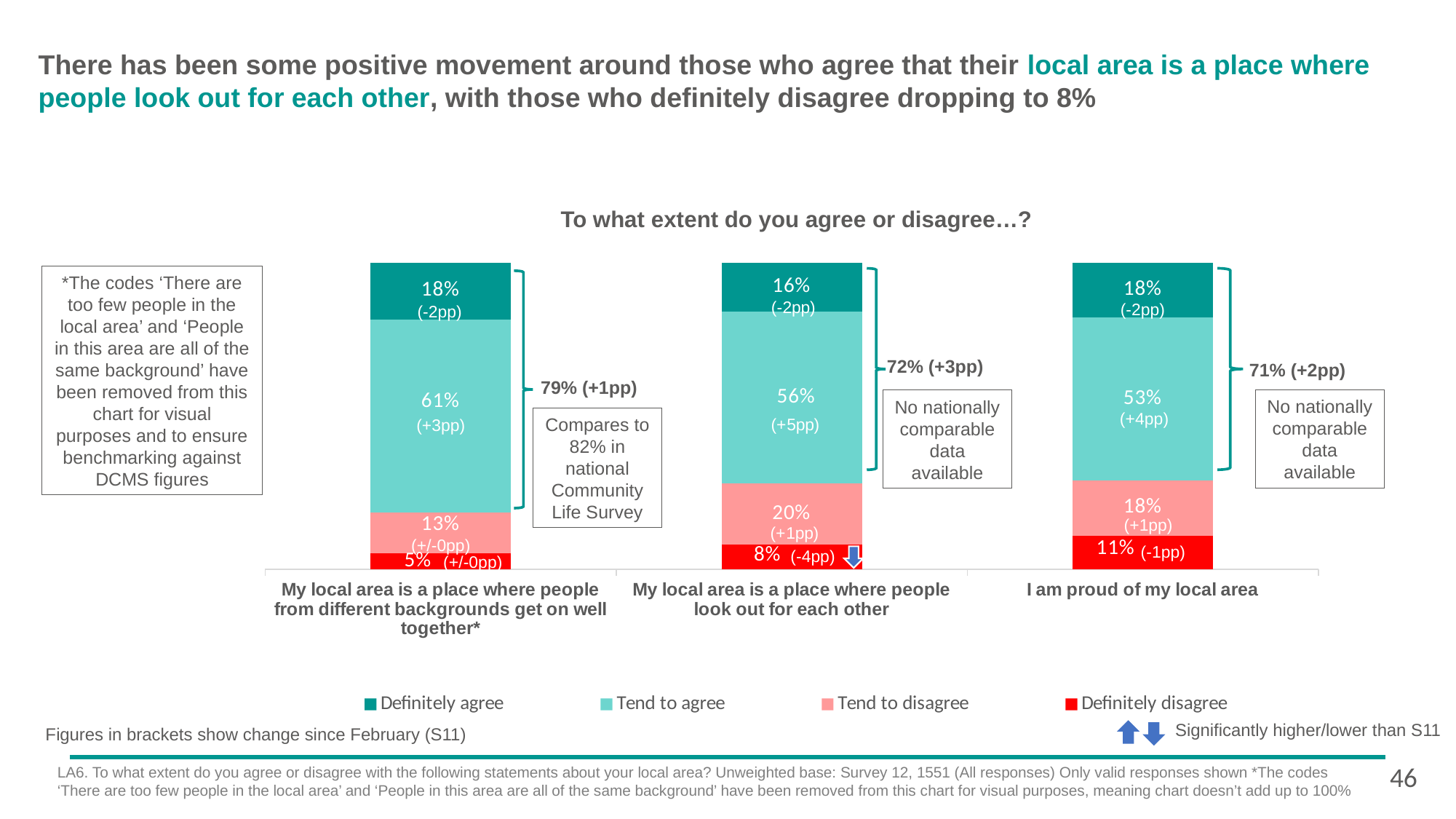
How many statements are shown on the x axis of the chart? 3 Which statement has the highest 'Tend to agree' percentage? My local area is a place where people from different backgrounds get on well together What type of chart is shown on the slide? Stacked bar chart What percentage 'Definitely disagree' with the statement 'I am proud of my local area'? 11% What is the title of the chart? To what extent do you agree or disagree…? What percentage of respondents 'Tend to agree' that their local area is a place where people look out for each other? 56% Which statement has the lowest 'Definitely disagree' percentage? My local area is a place where people from different backgrounds get on well together How many percentage points higher is 'Tend to agree' for 'different backgrounds get on well together' than for 'I am proud of my local area'? 8 percentage points What combined agree percentage is shown beside the bar for 'I am proud of my local area'? 71% (+2pp) How many series does the chart legend list? 4 Which has the larger 'Tend to disagree' share: 'people look out for each other' or 'I am proud of my local area'? My local area is a place where people look out for each other What is the change since February shown for 'Tend to agree' on 'My local area is a place where people look out for each other'? +5pp